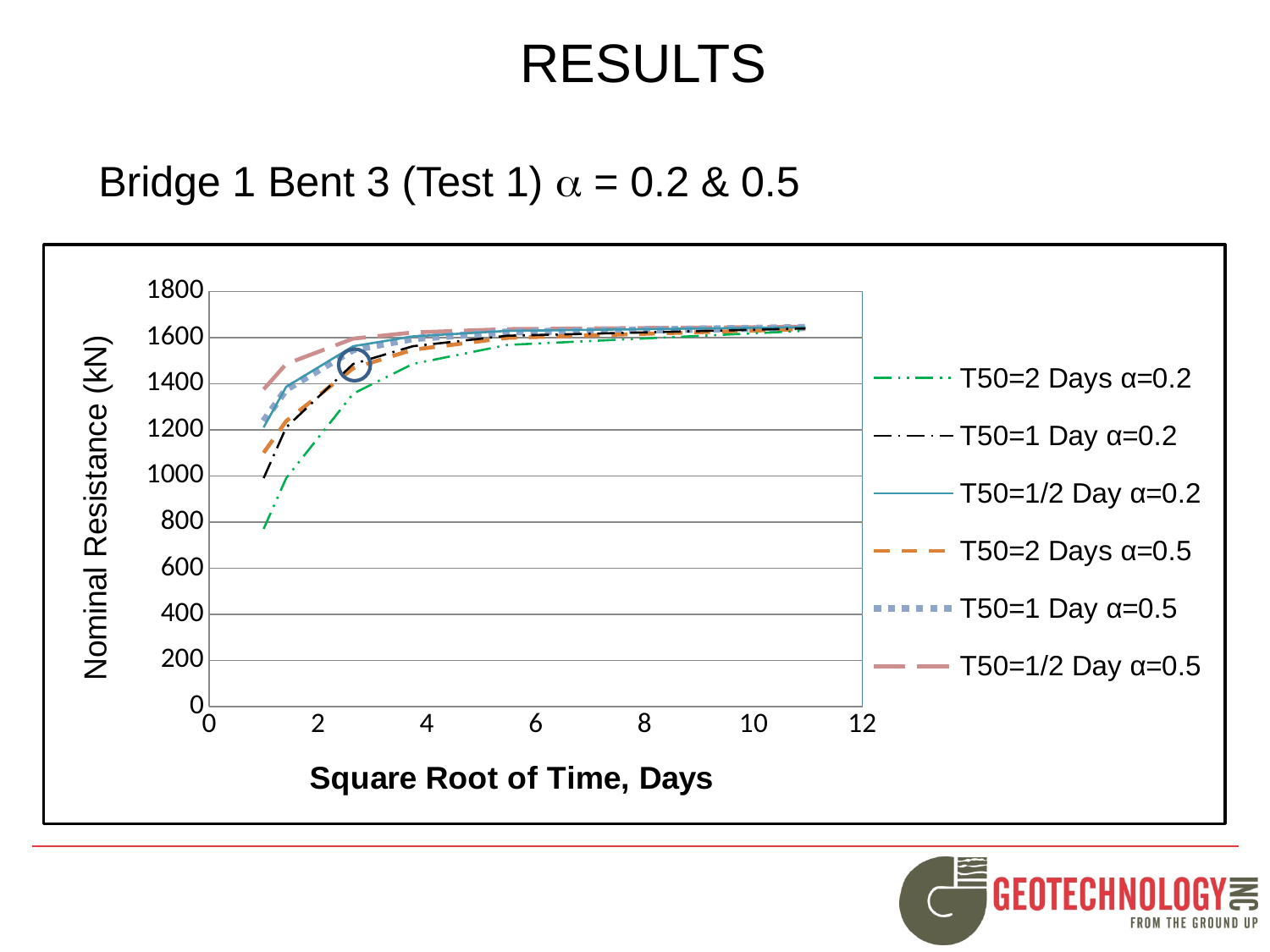
Is the starting value of the T50=1/2 Day α=0.5 series (at the left end of the curve) greater or less than 1200? greater Is the value of the T50=1 Day α=0.2 series at its left end greater or less than 1200? less Which series has the highest value at the left end of the curves (around x = 1)? T50=1/2 Day α=0.5 What kind of chart is shown on the slide? line chart At the left end of the curves, which series has the larger value: T50=2 Days α=0.5 or T50=2 Days α=0.2? T50=2 Days α=0.5 How many series does the chart's legend list? 6 Is the starting value of the T50=2 Days α=0.2 series (at the left end of the curve) greater or less than 1000? less What is the label of the chart's x axis? Square Root of Time, Days Which series has the lowest value at the left end of the curves (around x = 1)? T50=2 Days α=0.2 Do the values of the T50=2 Days α=0.2 series rise or fall as the x axis increases? rise What is the label of the chart's y axis? Nominal Resistance (kN)